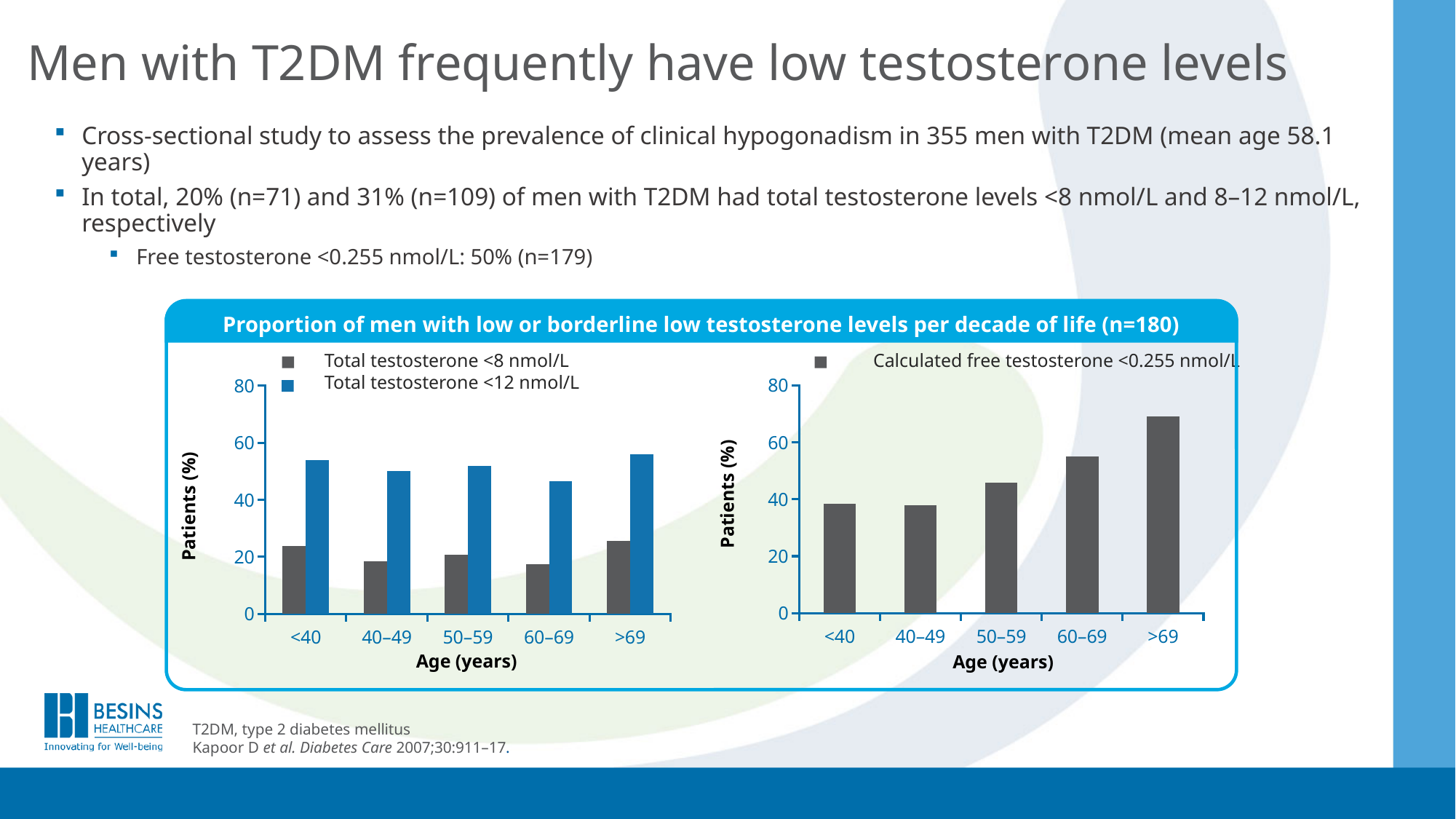
In the right-hand chart (Calculated free testosterone <0.255 nmol/L), is the value for the >69 age group greater or less than 60? greater What kind of chart is the right-hand chart (Calculated free testosterone <0.255 nmol/L)? Bar chart In the left-hand chart, for the 40–49 age group, which series has the larger value: Total testosterone <8 nmol/L or Total testosterone <12 nmol/L? Total testosterone <12 nmol/L In the right-hand chart (Calculated free testosterone <0.255 nmol/L), is the value for the 50–59 age group greater or less than 40? greater In the right-hand chart (Calculated free testosterone <0.255 nmol/L), which is larger: the value for 60–69 or the value for 50–59? 60–69 In the left-hand chart, is the Total testosterone <8 nmol/L value for the 60–69 age group greater or less than 20? less What is the title shown above the two charts? Proportion of men with low or borderline low testosterone levels per decade of life (n=180) In the right-hand chart (Calculated free testosterone <0.255 nmol/L), do the values generally rise or fall as age increases along the x axis? Rise How many age categories are shown on the x axis of the right-hand chart? 5 How many series does the legend of the left-hand chart list? 2 In the right-hand chart (Calculated free testosterone <0.255 nmol/L), which age group has the highest proportion of patients? >69